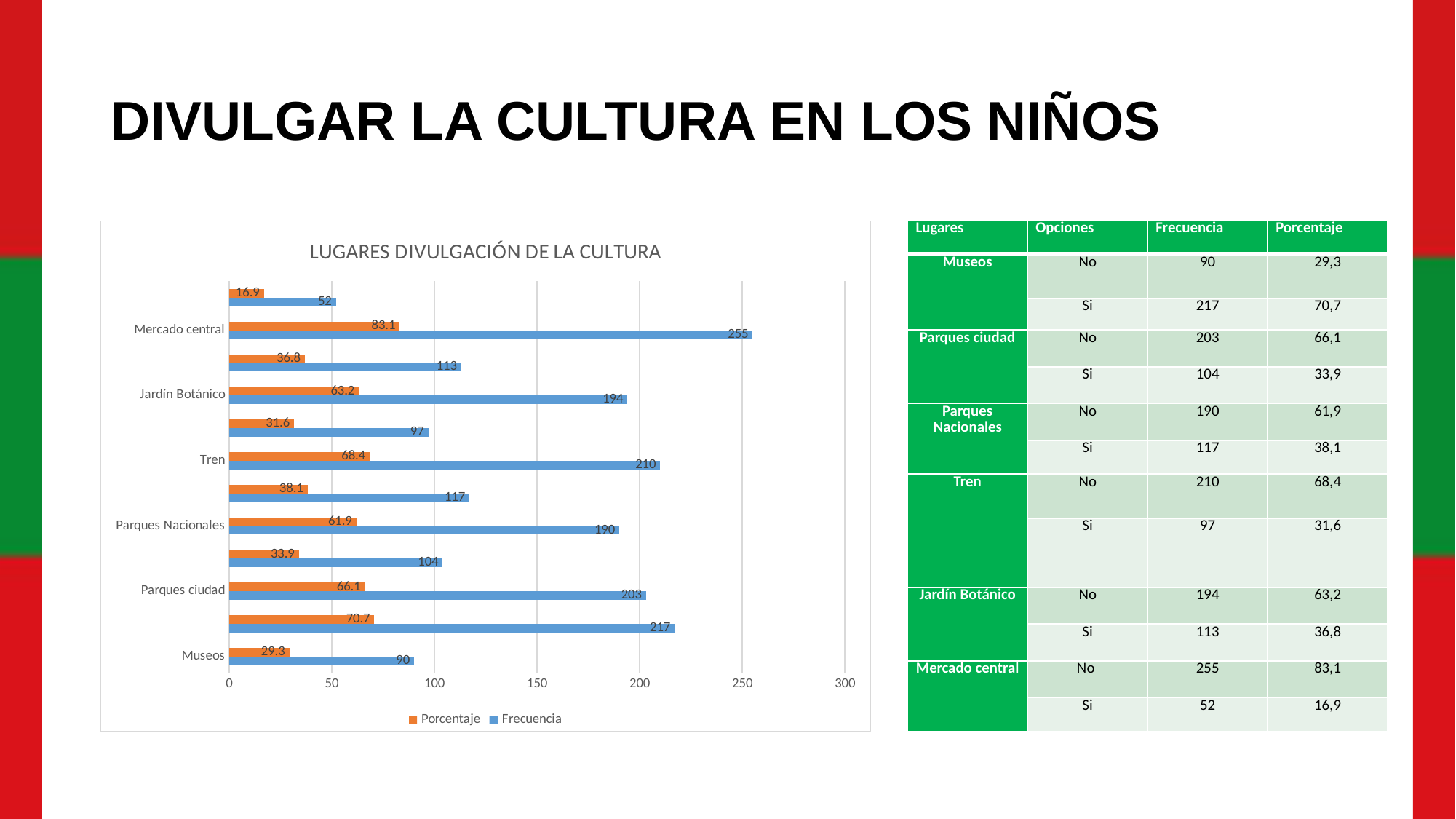
What is the Porcentaje value labelled on the bar for Museos? 29.3 How many category labels appear on the vertical axis of the chart? 6 What is the Porcentaje value labelled on the bar for Tren? 68.4 What is the Frecuencia value labelled on the bar for Mercado central? 255 How many series does the legend of the chart list? 2 What is the difference between the Frecuencia values labelled for Tren and Parques Nacionales? 20 What is the title of the chart? LUGARES DIVULGACIÓN DE LA CULTURA Which labelled category has the highest Frecuencia bar? Mercado central What type of chart is shown under the title LUGARES DIVULGACIÓN DE LA CULTURA? Bar chart Which has the larger Frecuencia value, Jardín Botánico or Parques ciudad? Parques ciudad Is the Frecuencia value for Museos greater or less than 100? less Which labelled category has the highest Porcentaje bar? Mercado central